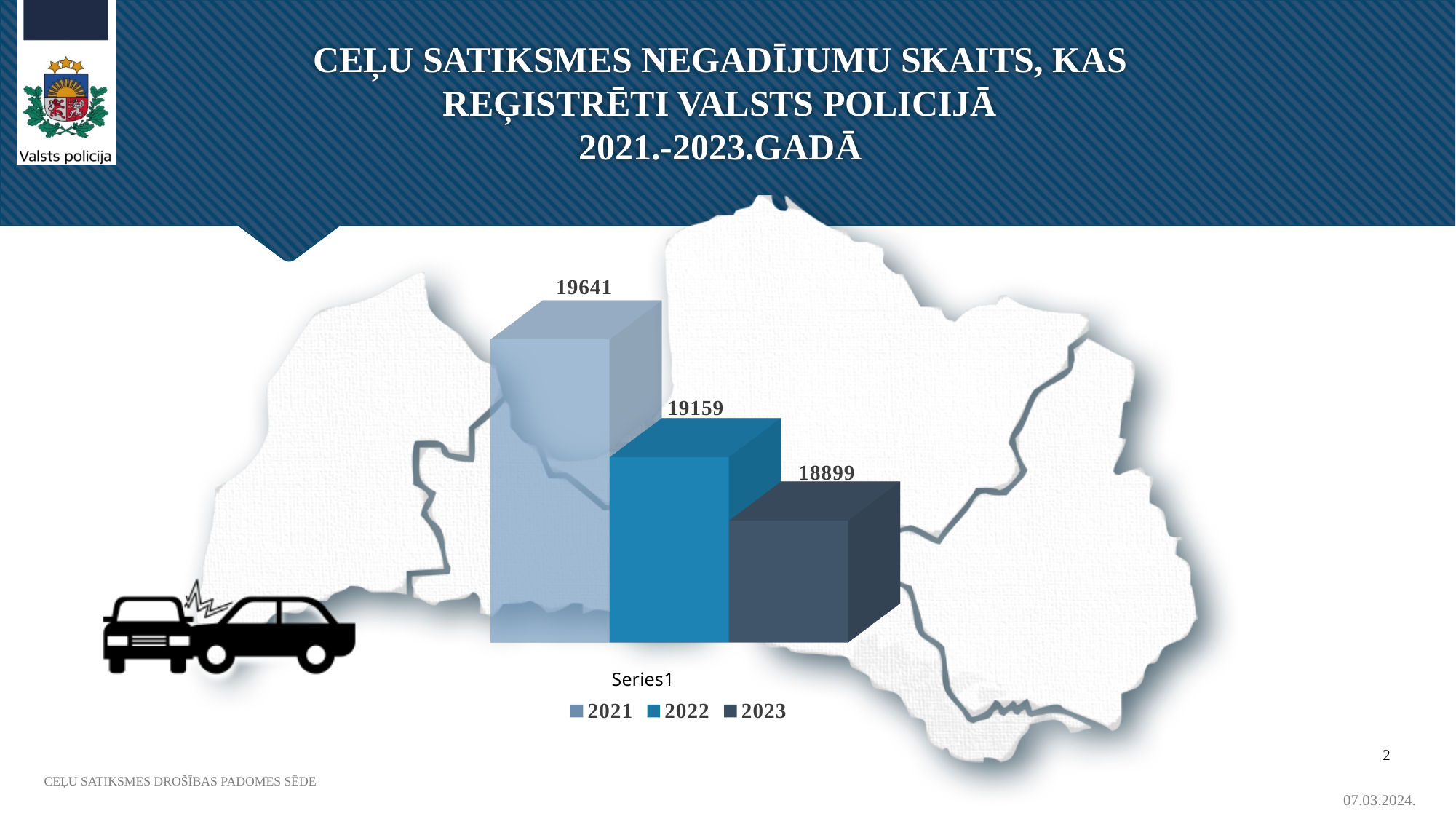
What is the value shown for 2021? 19641 Which year has the highest value? 2021 Which year has the lowest value? 2023 What is the value shown for 2023? 18899 What is the difference between the values for 2021 and 2022? 482 Which is larger, the value for 2022 or the value for 2023? 2022 How many series does the legend list? 3 What kind of chart is shown on the slide? bar chart What is the category label shown below the bars? Series1 Do the values rise or fall from 2021 to 2023? fall What is the difference between the values for 2021 and 2023? 742 What is the value shown for 2022? 19159